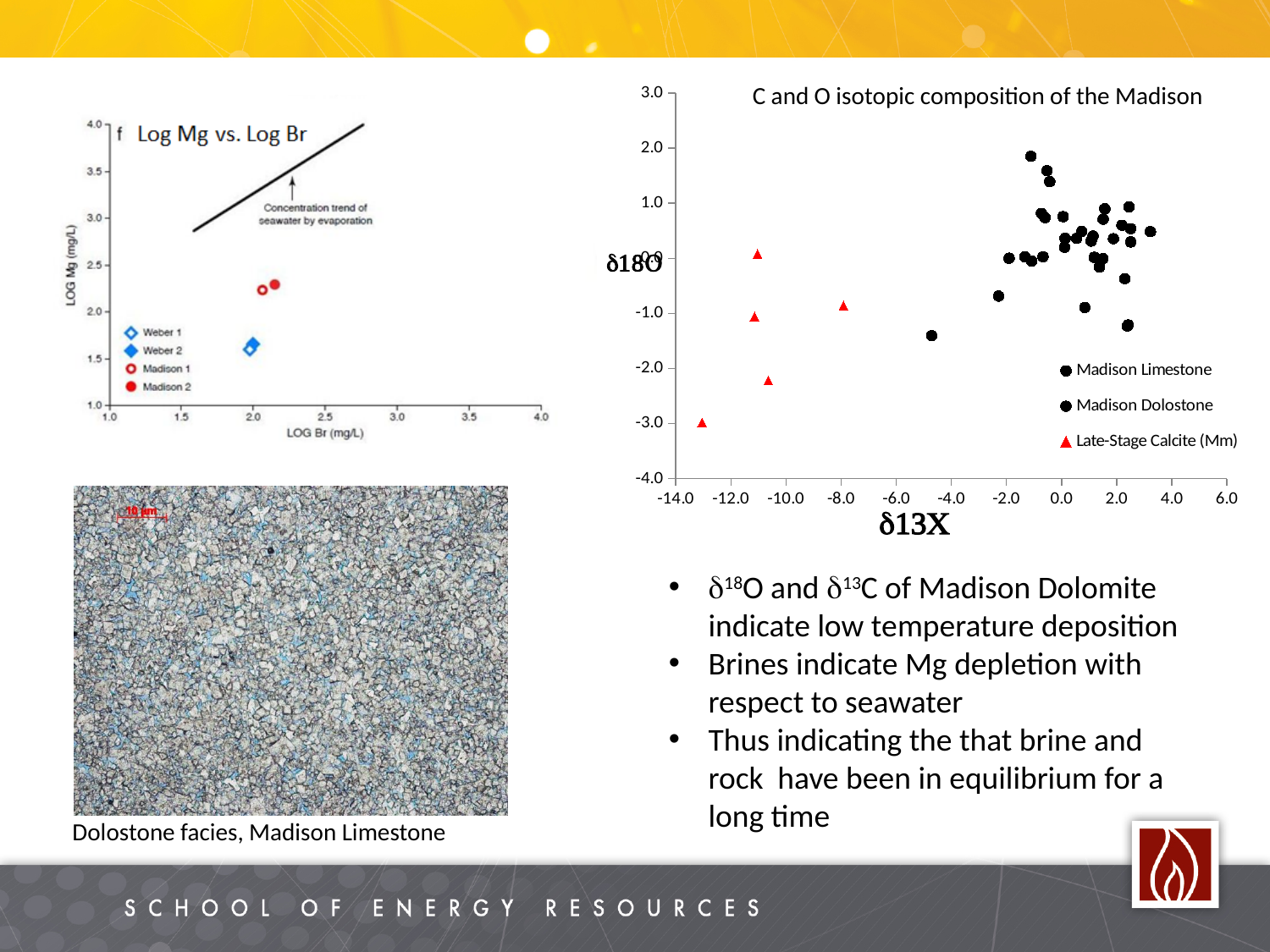
How many series does the legend of the 'Log Mg vs. Log Br' chart list? 4 In the 'C and O isotopic composition of the Madison' chart, is the highest δ18O value among the black circle points greater or less than 1.0? greater What is the maximum value shown on the x axis of the 'C and O isotopic composition of the Madison' chart? 6.0 In the 'C and O isotopic composition of the Madison' chart, which series is plotted with red triangles? Late-Stage Calcite (Mm) How many series does the legend of the 'C and O isotopic composition of the Madison' chart list? 3 In the 'C and O isotopic composition of the Madison' chart, is the δ13X value of the leftmost Late-Stage Calcite (Mm) point greater or less than -12.0? less In the 'Log Mg vs. Log Br' chart, is the LOG Mg value of the Weber 1 point greater or less than 2.0? less What kind of chart is the 'Log Mg vs. Log Br' chart? Scatter chart In the 'C and O isotopic composition of the Madison' chart, which series has the lowest δ13X values? Late-Stage Calcite (Mm) What kind of chart is the 'C and O isotopic composition of the Madison' chart? Scatter chart In the 'Log Mg vs. Log Br' chart, which have higher LOG Mg values, the Madison samples or the Weber samples? Madison samples